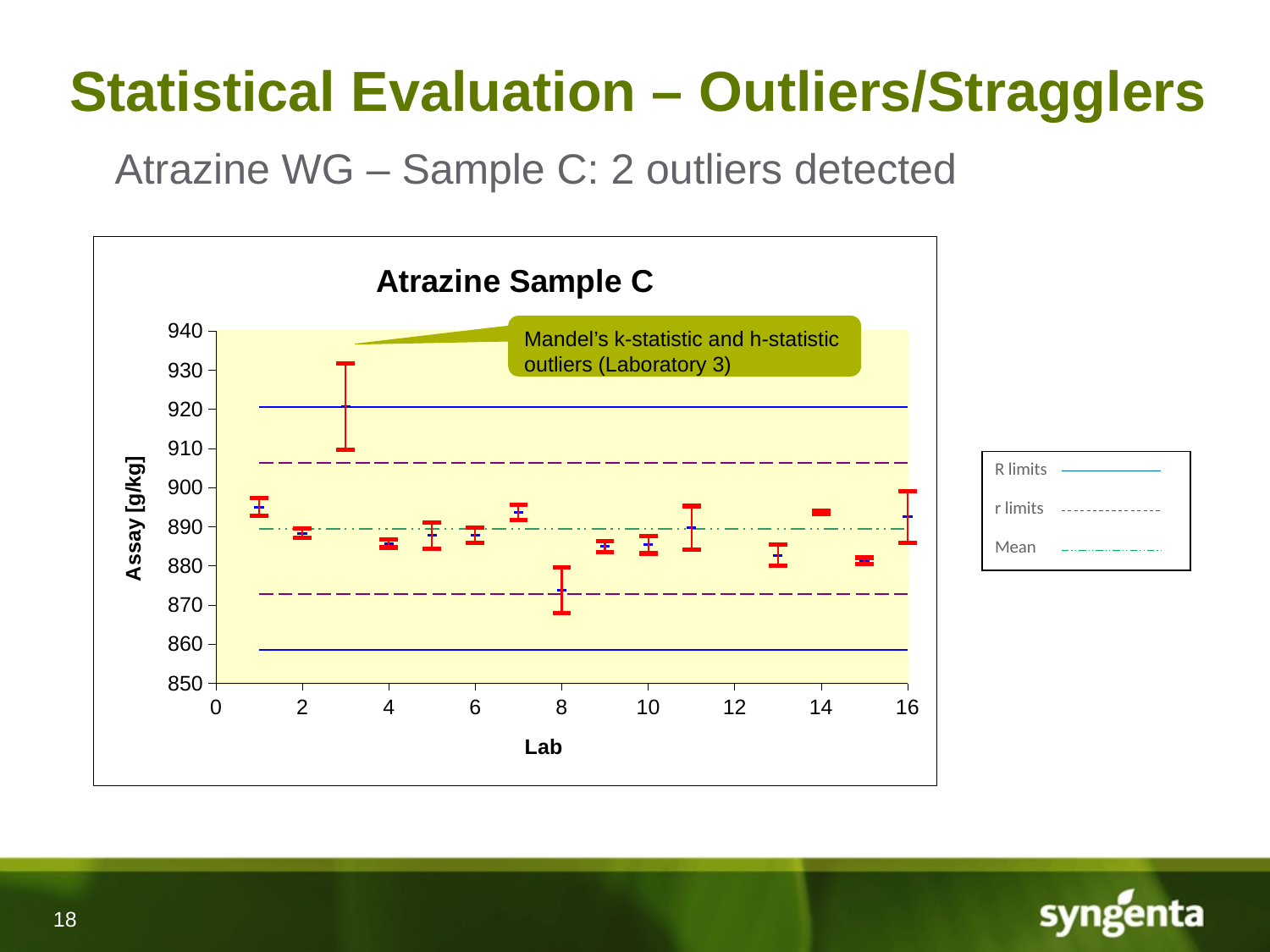
Which lab has the larger assay value, Lab 14 or Lab 13? Lab 14 Which lab has the highest assay value on the chart? Lab 3 How many labs are plotted on the chart? 15 Is the assay value for Lab 8 greater or less than 880? less How many entries does the chart's legend list? 3 What is the title of the chart? Atrazine Sample C Which lab has the larger assay value, Lab 3 or Lab 8? Lab 3 Is the assay value for Lab 3 greater or less than 910? greater Is the assay value for Lab 1 greater or less than 890? greater What is the label of the y-axis of the chart? Assay [g/kg] Which lab has the lowest assay value on the chart? Lab 8